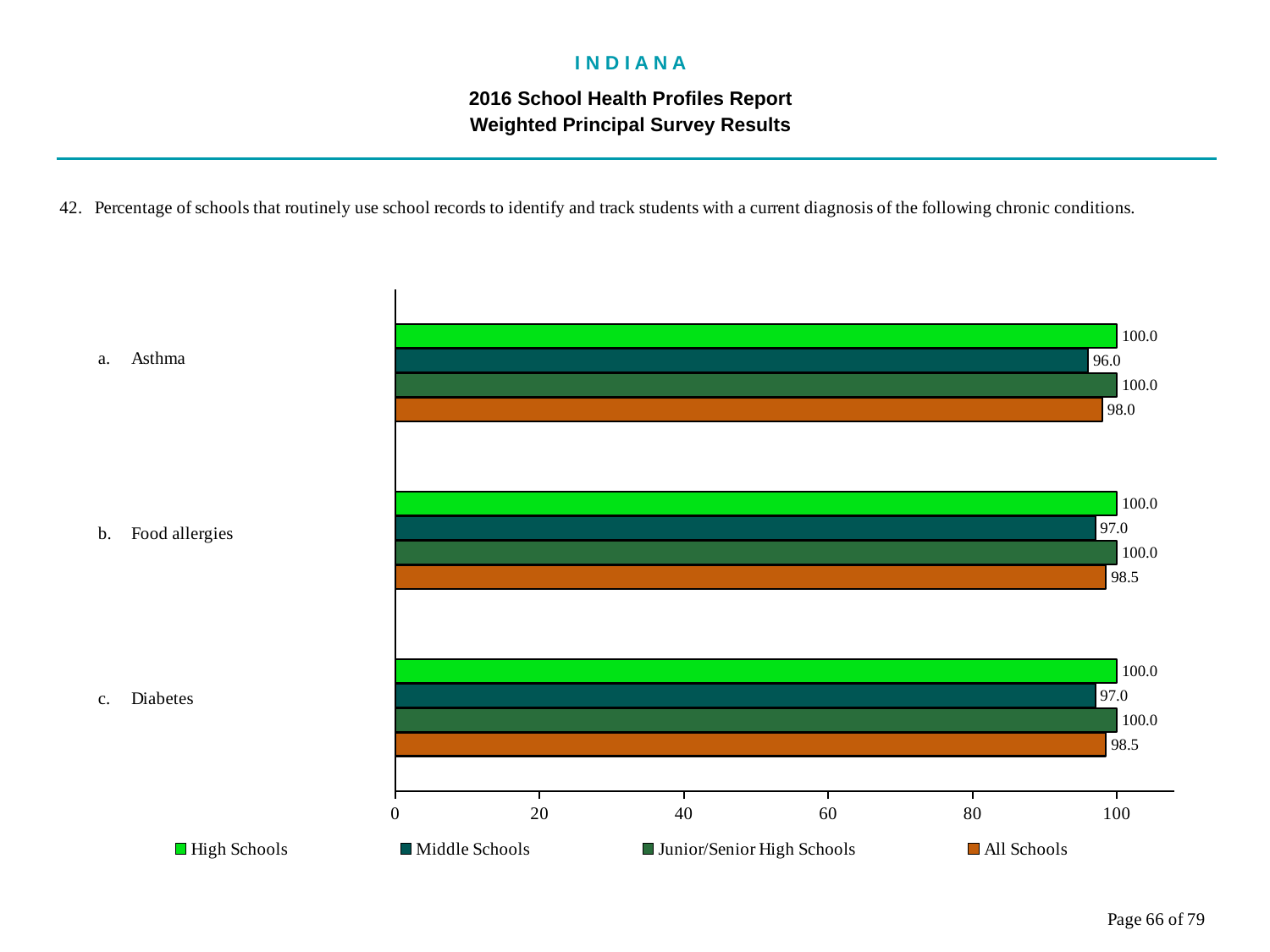
Which series has the lowest value for Asthma? Middle Schools What kind of chart is shown on the slide? Bar chart What is the difference between the All Schools values for Food allergies and Asthma? 0.5 What is the value for Middle Schools for Asthma? 96.0 What is the value for All Schools for Food allergies? 98.5 Which legend entry is shown in orange? All Schools What is the value for High Schools for Diabetes? 100.0 Which is larger for Diabetes: the Middle Schools value or the All Schools value? All Schools How many chronic conditions (categories) are shown on the chart? 3 What is the difference between the High Schools and Middle Schools values for Food allergies? 3.0 What is the value for All Schools for Asthma? 98.0 How many series does the legend list? 4